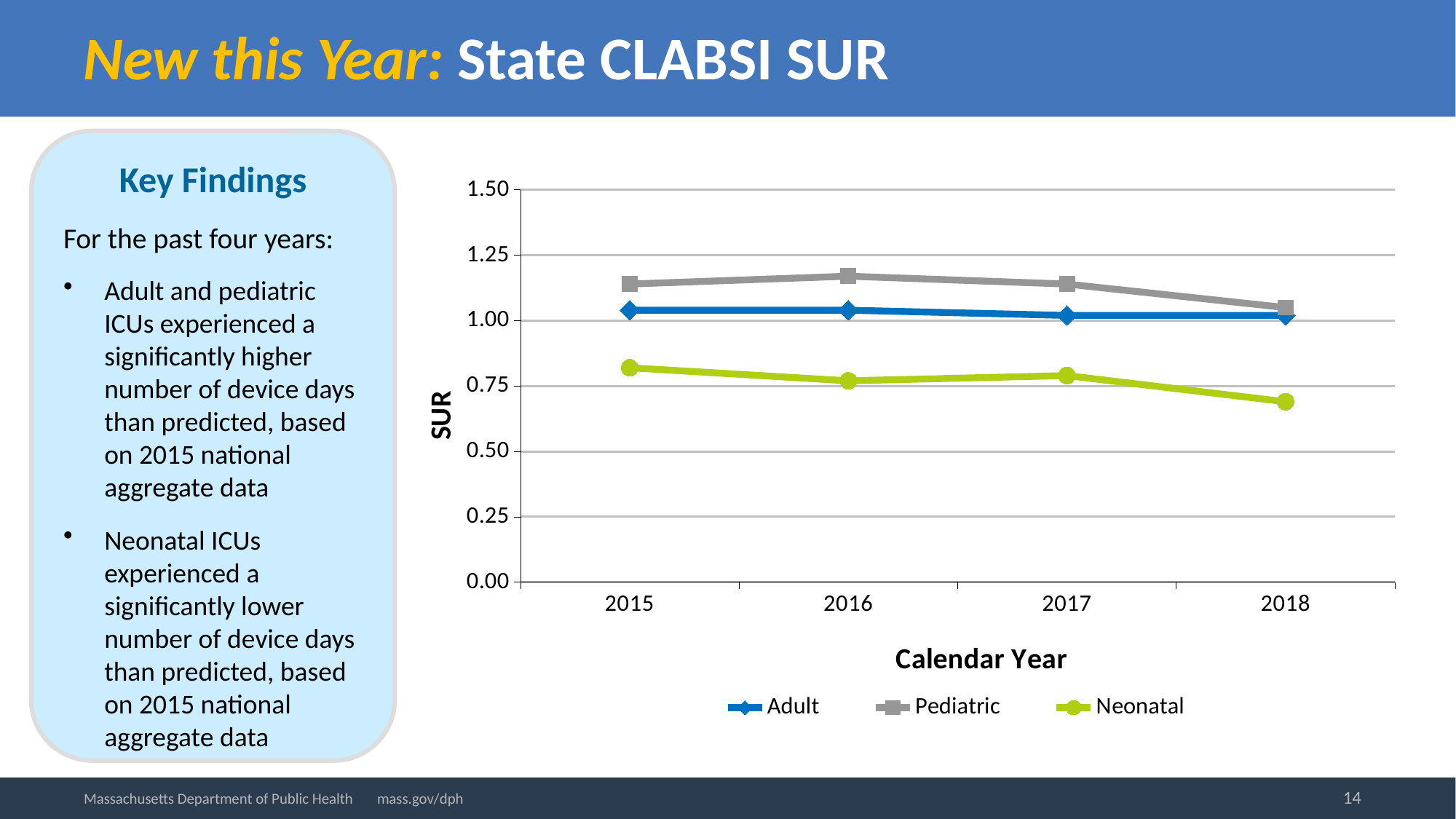
Is the Neonatal SUR in 2018 greater or less than 0.75? less In which year is the Neonatal SUR lowest? 2018 Does the Pediatric SUR rise or fall from 2016 to 2018? Fall Is the Pediatric SUR in 2016 greater or less than 1.00? greater What is the title of the x axis? Calendar Year How many calendar years are plotted on the x axis? 4 What kind of chart is shown on the slide? Line chart Is the Neonatal SUR in 2015 greater or less than 0.75? greater Which series has the lowest SUR in 2016? Neonatal How many series does the legend list? 3 Which series has the highest SUR in 2017? Pediatric Which is larger in 2016, the Pediatric SUR or the Neonatal SUR? Pediatric